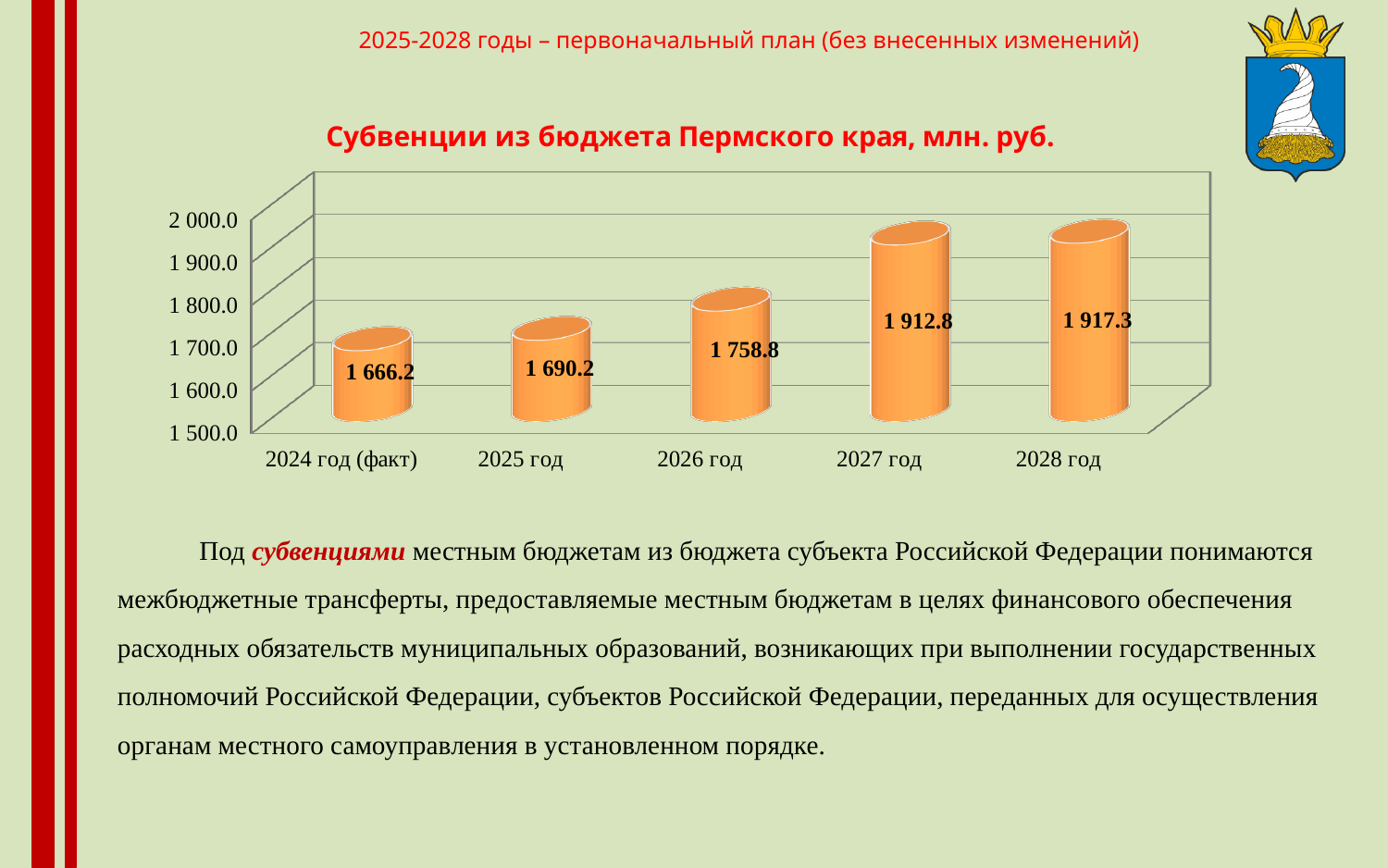
Which year has the lowest value in the chart? 2024 год (факт) What is the value for 2025 год in the chart 'Субвенции из бюджета Пермского края, млн. руб.'? 1 690.2 Which year has the highest value in the chart? 2028 год What is the difference between the values for 2027 год and 2026 год? 154.0 What is the value for 2027 год? 1 912.8 Which is larger, the value for 2026 год or the value for 2025 год? 2026 год What kind of chart is shown on the slide? bar chart What is the difference between the values for 2028 год and 2024 год (факт)? 251.1 Is the value for 2026 год greater or less than 1 800.0? less What is the value for 2024 год (факт)? 1 666.2 Do the values rise or fall from 2024 год (факт) to 2028 год? rise How many years are shown on the x axis of the chart? 5